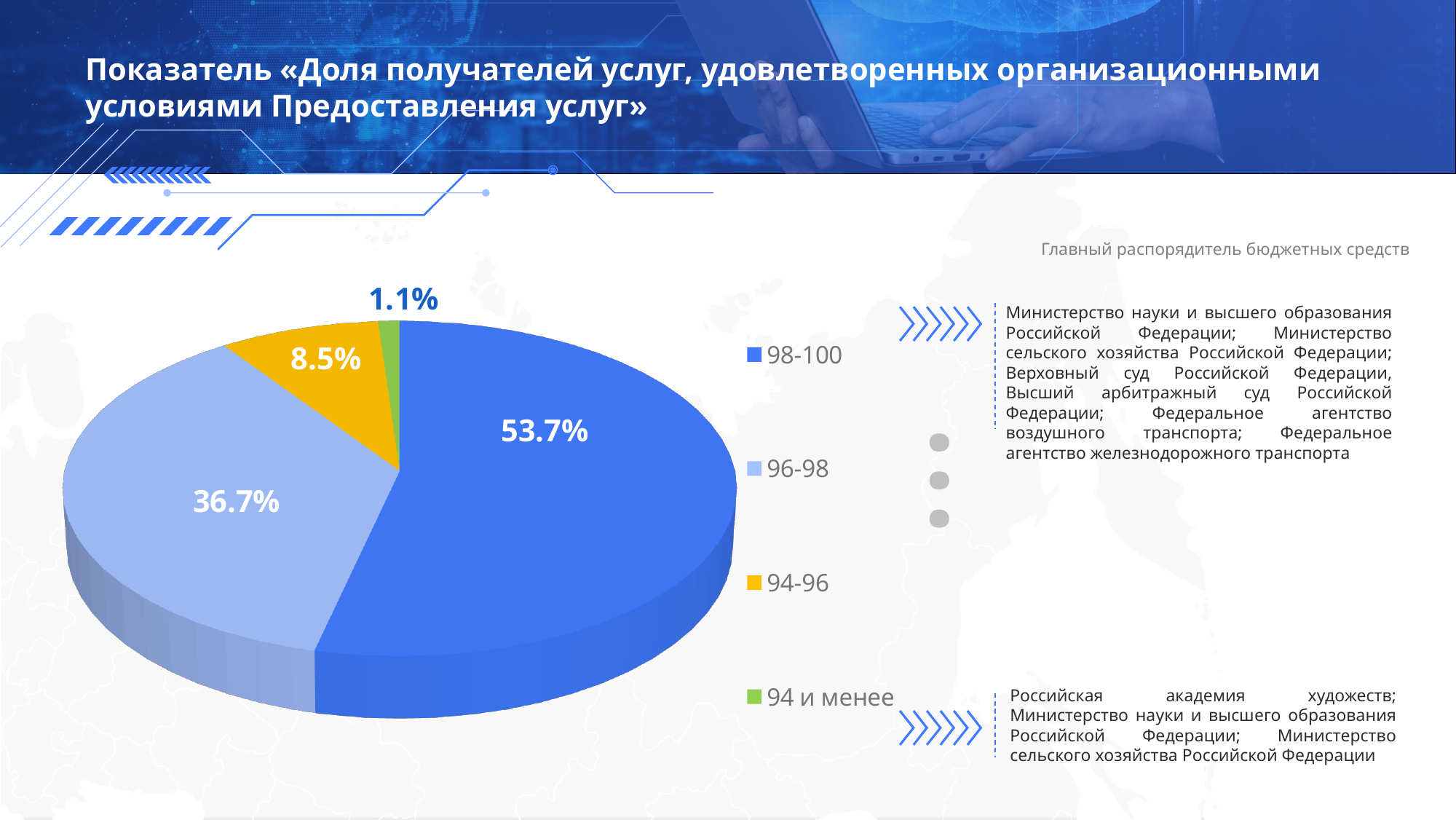
What colour is the "94-96" slice in the pie chart? Yellow What kind of chart is shown on the slide? Pie chart Which slice is larger, "96-98" or "94-96"? 96-98 Which category has the smallest slice of the pie? 94 и менее Which category has the largest slice of the pie? 98-100 What is the difference between the "94-96" and "94 и менее" slices? 7.4% What share of the pie does the "98-100" slice represent? 53.7% What is the difference between the "98-100" and "96-98" slices? 17.0% What share of the pie does the "94 и менее" slice represent? 1.1% How many slices does the pie chart have? 4 What share of the pie does the "96-98" slice represent? 36.7% What share of the pie does the "94-96" slice represent? 8.5%